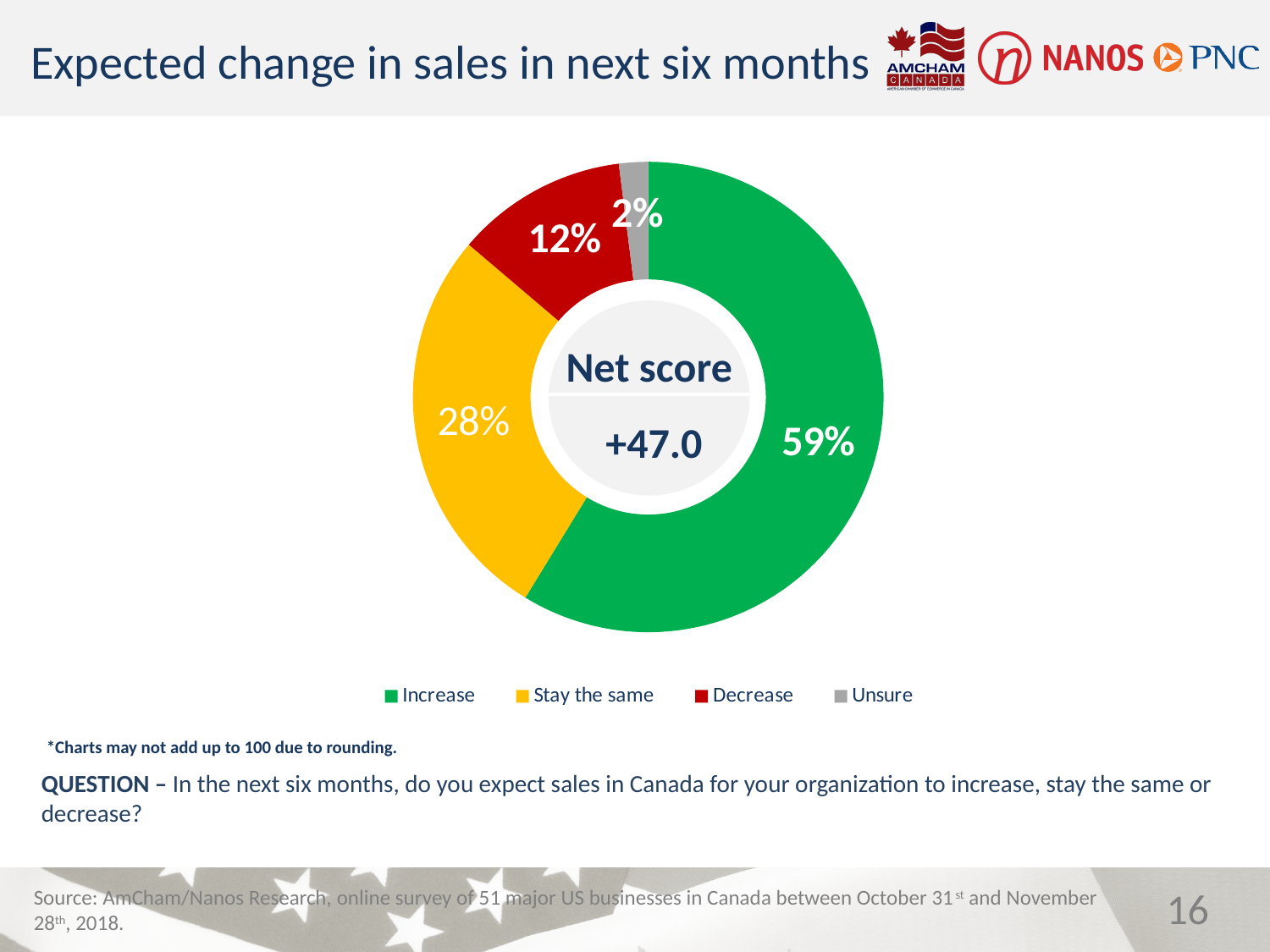
What kind of chart is shown on the slide? Pie chart (doughnut) What percentage of respondents are unsure? 2% What percentage of respondents expect sales to decrease? 12% What colour represents the Decrease category? Red How many categories does the legend list? 4 What net score is shown in the centre of the chart? +47.0 What percentage of respondents expect sales to stay the same? 28% Which response category has the largest share of the chart? Increase Which is larger, the share for Stay the same or the share for Decrease? Stay the same Which response category has the smallest share of the chart? Unsure What percentage of respondents expect sales to increase? 59% What is the difference in percentage points between Increase and Stay the same? 31